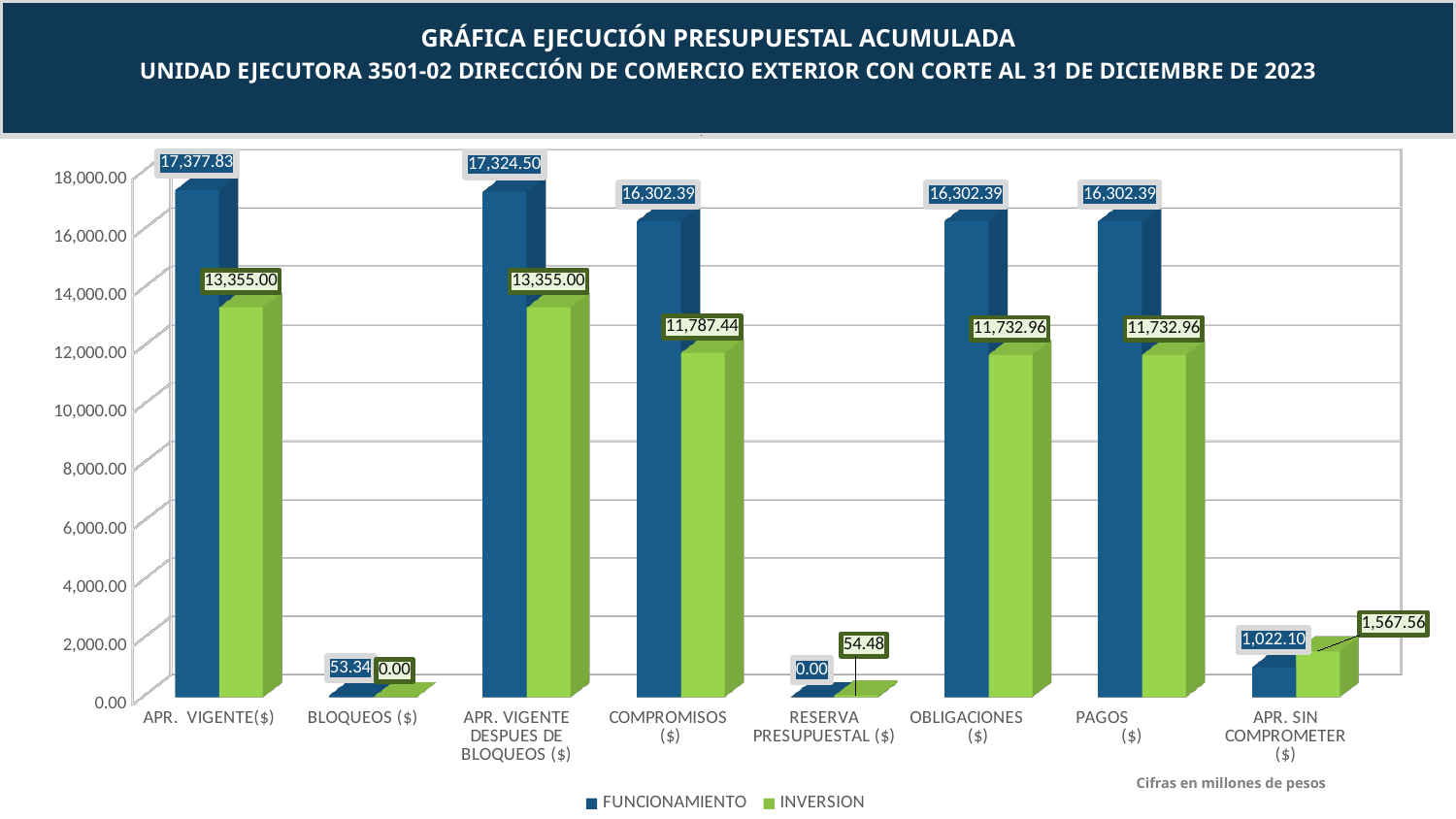
What is the FUNCIONAMIENTO value for APR. VIGENTE($)? 17,377.83 How many categories are shown on the x axis? 8 Which category has the highest FUNCIONAMIENTO value? APR. VIGENTE($) What is the difference between the FUNCIONAMIENTO values for APR. VIGENTE($) and APR. VIGENTE DESPUES DE BLOQUEOS ($)? 53.33 Which category has the lowest INVERSION value? BLOQUEOS ($) What kind of chart is shown on the slide? Bar chart For APR. SIN COMPROMETER ($), which series has the larger value, FUNCIONAMIENTO or INVERSION? INVERSION What is the INVERSION value for COMPROMISOS ($)? 11,787.44 What is the INVERSION value for APR. SIN COMPROMETER ($)? 1,567.56 What is the difference between the INVERSION values for COMPROMISOS ($) and OBLIGACIONES ($)? 54.48 How many series does the legend list? 2 What is the FUNCIONAMIENTO value for BLOQUEOS ($)? 53.34